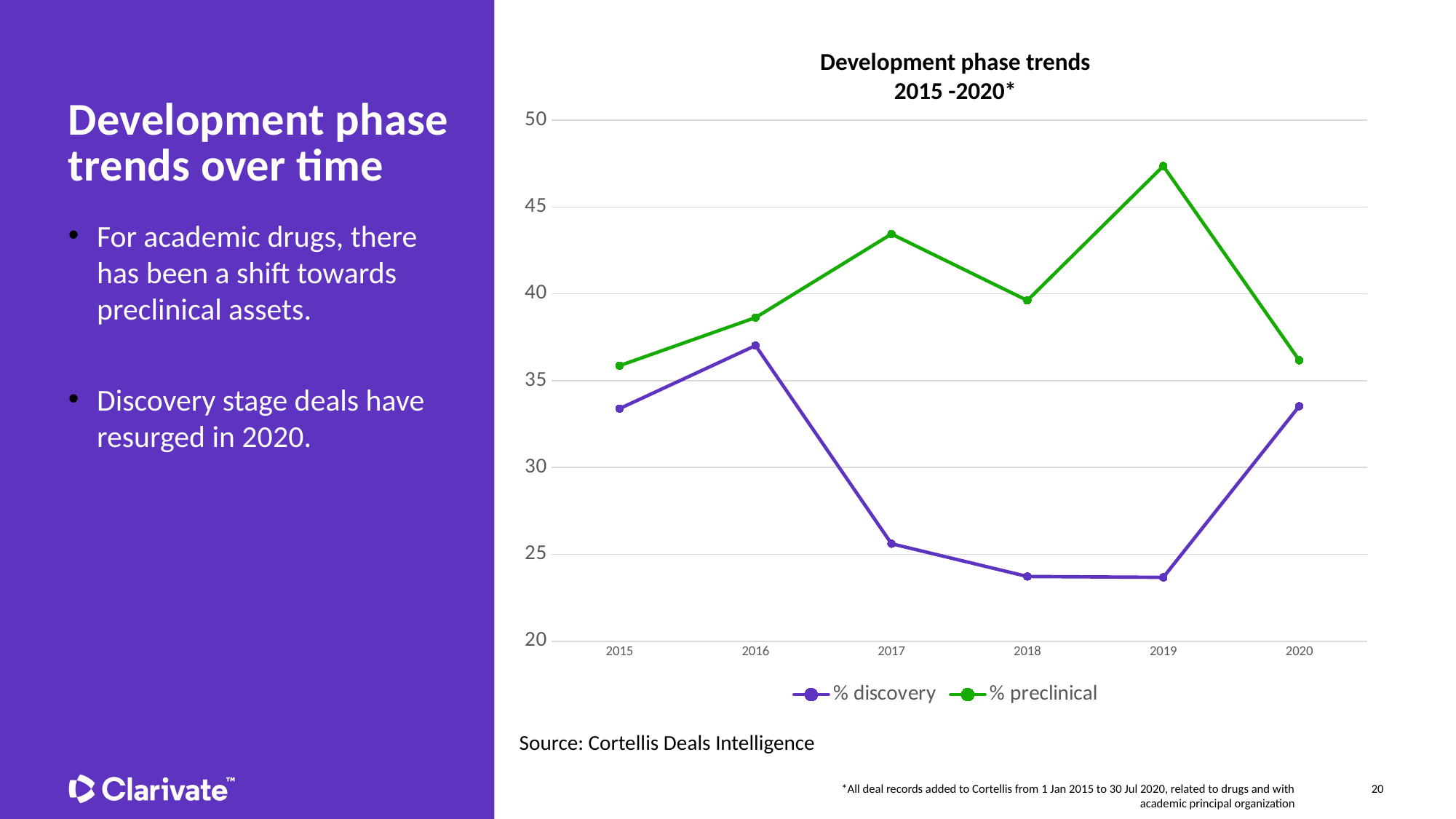
Is the value for % preclinical in 2017 greater or less than 40? greater In which year does the % discovery series reach its highest value? 2016 What kind of chart is shown on the slide? line chart Is the value for % preclinical in 2019 greater or less than 45? greater What is the title of the chart? Development phase trends 2015 -2020* How many series does the legend list? 2 Is the value for % discovery in 2016 greater or less than 35? greater In 2017, which series has the larger value, % discovery or % preclinical? % preclinical In which year does the % preclinical series reach its highest value? 2019 How many years are plotted along the x axis? 6 Does the % discovery series rise or fall from 2016 to 2018? fall